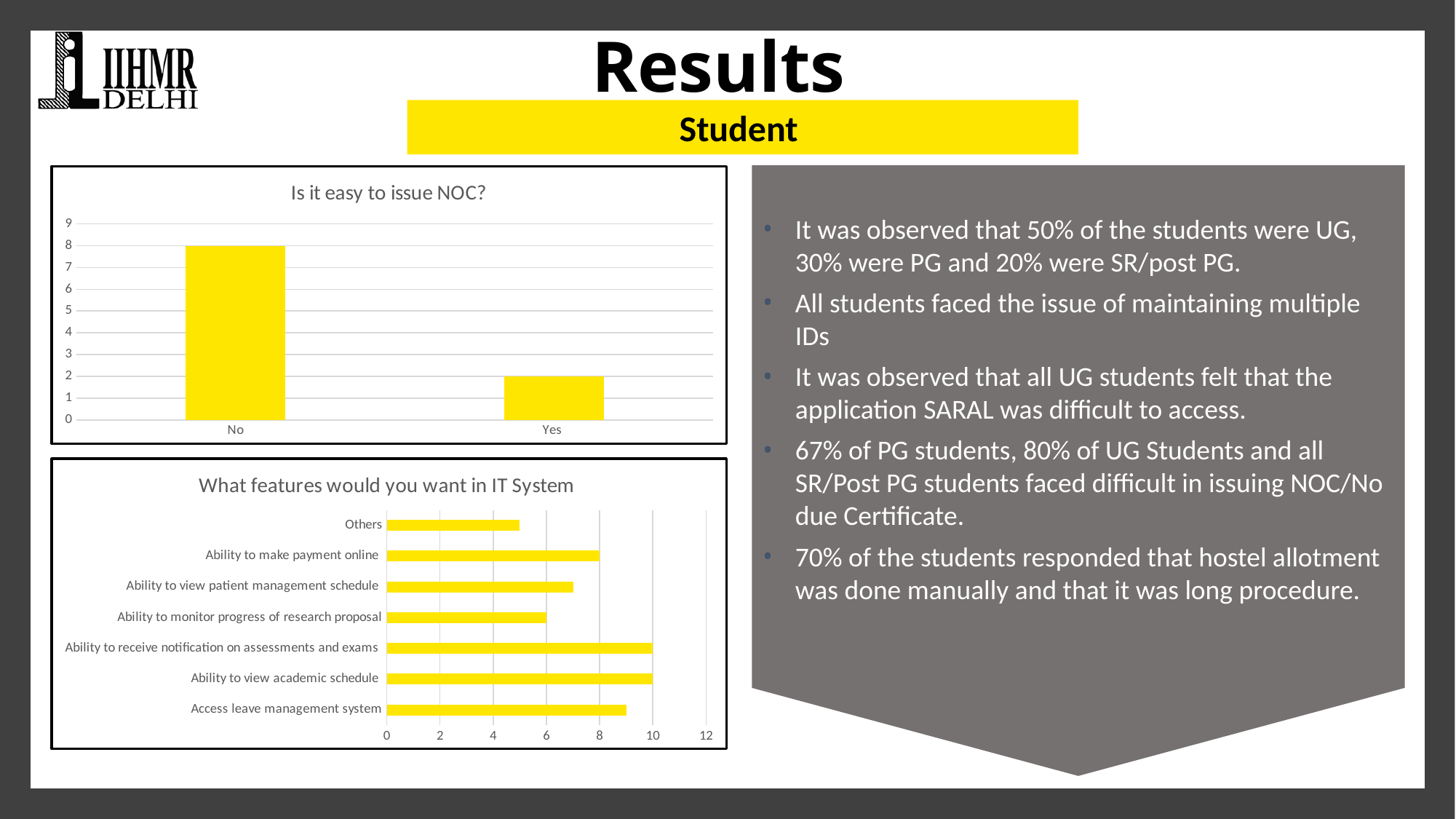
In the chart 'What features would you want in IT System', which feature has the lowest value? Others In the chart 'What features would you want in IT System', is the value for 'Access leave management system' greater or less than 8? greater In the chart 'What features would you want in IT System', how many features are listed? 7 In the chart 'What features would you want in IT System', what is the value for 'Ability to make payment online'? 8 In the chart 'Is it easy to issue NOC?', what is the value for No? 8 In the chart 'What features would you want in IT System', what is the value for 'Ability to view academic schedule'? 10 What kind of chart is 'Is it easy to issue NOC?'? Bar chart In the chart 'Is it easy to issue NOC?', what is the difference between the No and Yes values? 6 In the chart 'Is it easy to issue NOC?', what is the value for Yes? 2 In the chart 'What features would you want in IT System', which is larger: 'Ability to receive notification on assessments and exams' or 'Ability to view patient management schedule'? Ability to receive notification on assessments and exams In the chart 'What features would you want in IT System', what is the value for 'Ability to monitor progress of research proposal'? 6 In the chart 'Is it easy to issue NOC?', which category has the higher value, No or Yes? No